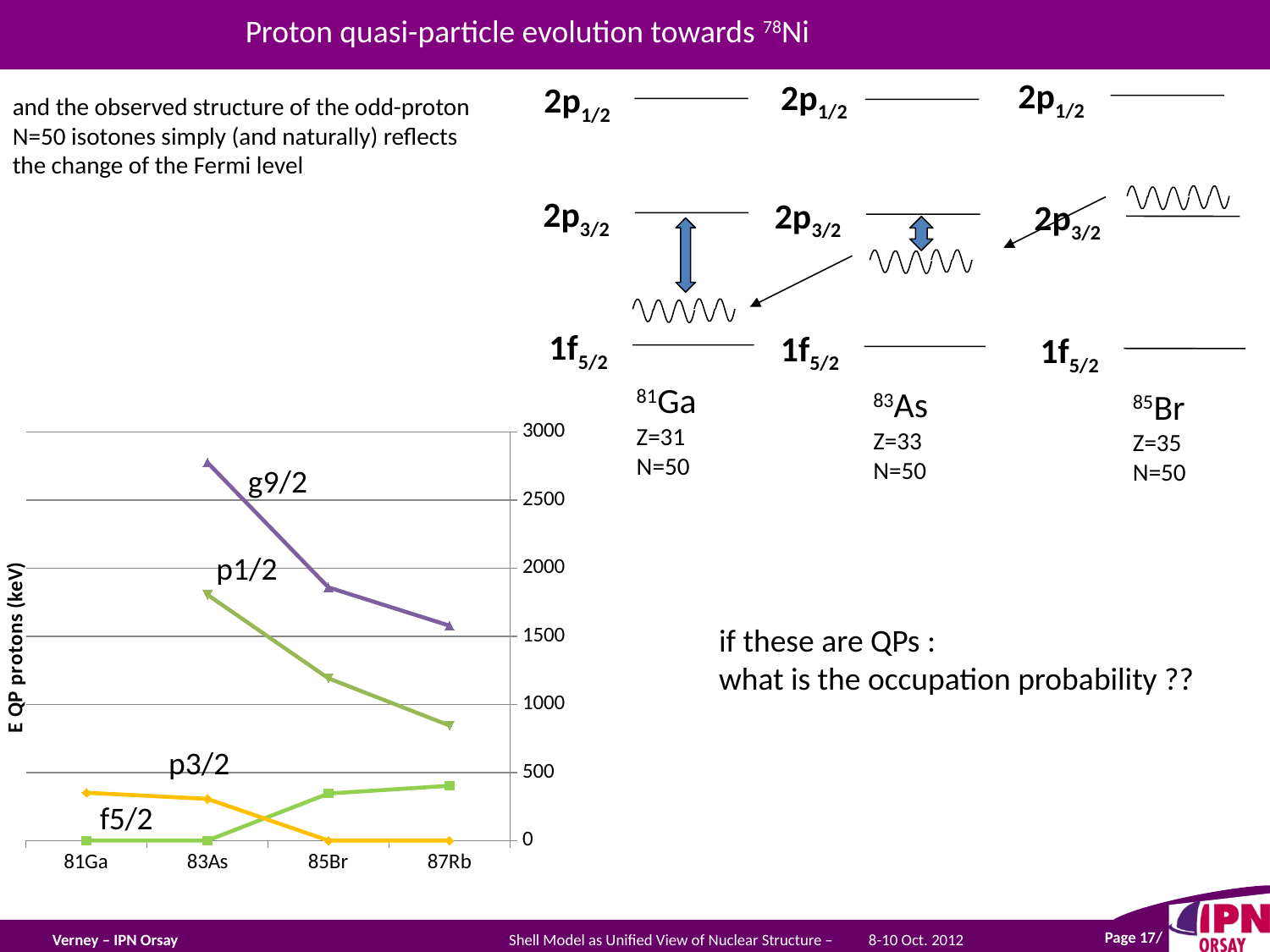
Is the value of the g9/2 line at 83As greater or less than 2500? greater Does the g9/2 line rise or fall from 83As to 87Rb? fall At which category does the g9/2 line reach its highest value? 83As Is the value of the f5/2 line at 81Ga greater or less than 500? less How many categories are shown on the x axis of the chart? 4 At 81Ga, which line has the larger value, f5/2 or p3/2? p3/2 What is the label of the vertical axis of the chart? E QP protons (keV) Is the value of the p1/2 line at 85Br greater or less than 1000? greater At 87Rb, which line has the larger value, g9/2 or p1/2? g9/2 Does the p3/2 line rise or fall from 81Ga to 87Rb? fall What kind of chart is shown on the slide? line chart